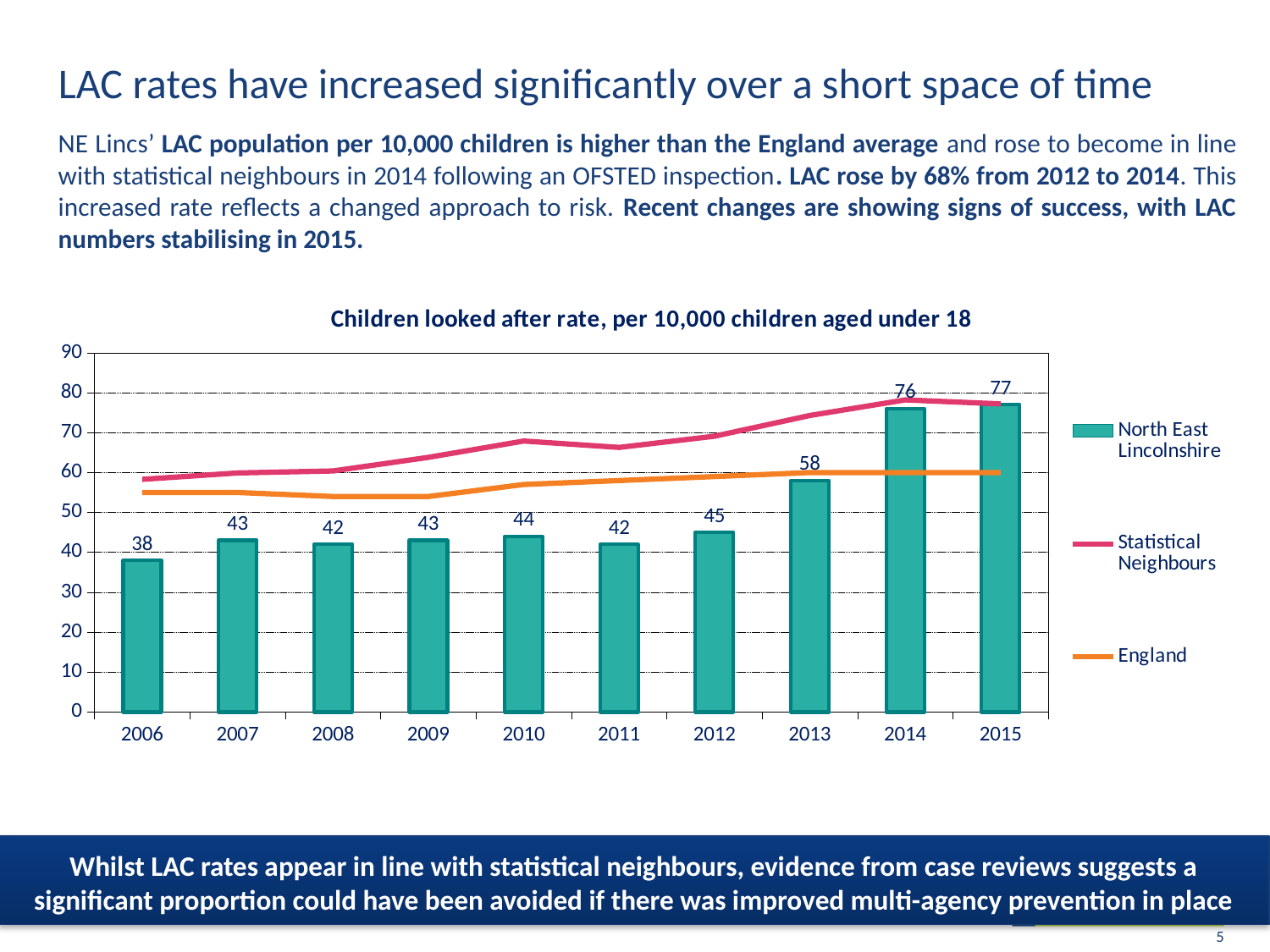
How many years are shown on the x axis? 10 Which year has the lowest North East Lincolnshire value? 2006 Is the England value for 2006 greater or less than 50? greater Which is larger, the North East Lincolnshire value for 2010 or for 2011? 2010 What is the North East Lincolnshire value for 2013? 58 How many series does the legend list? 3 What is the North East Lincolnshire value for 2006? 38 What is the difference between the North East Lincolnshire values for 2014 and 2012? 31 Which year has the highest North East Lincolnshire value? 2015 Is the Statistical Neighbours value for 2010 greater or less than 60? greater What is the title of the chart? Children looked after rate, per 10,000 children aged under 18 What is the North East Lincolnshire value for 2015? 77